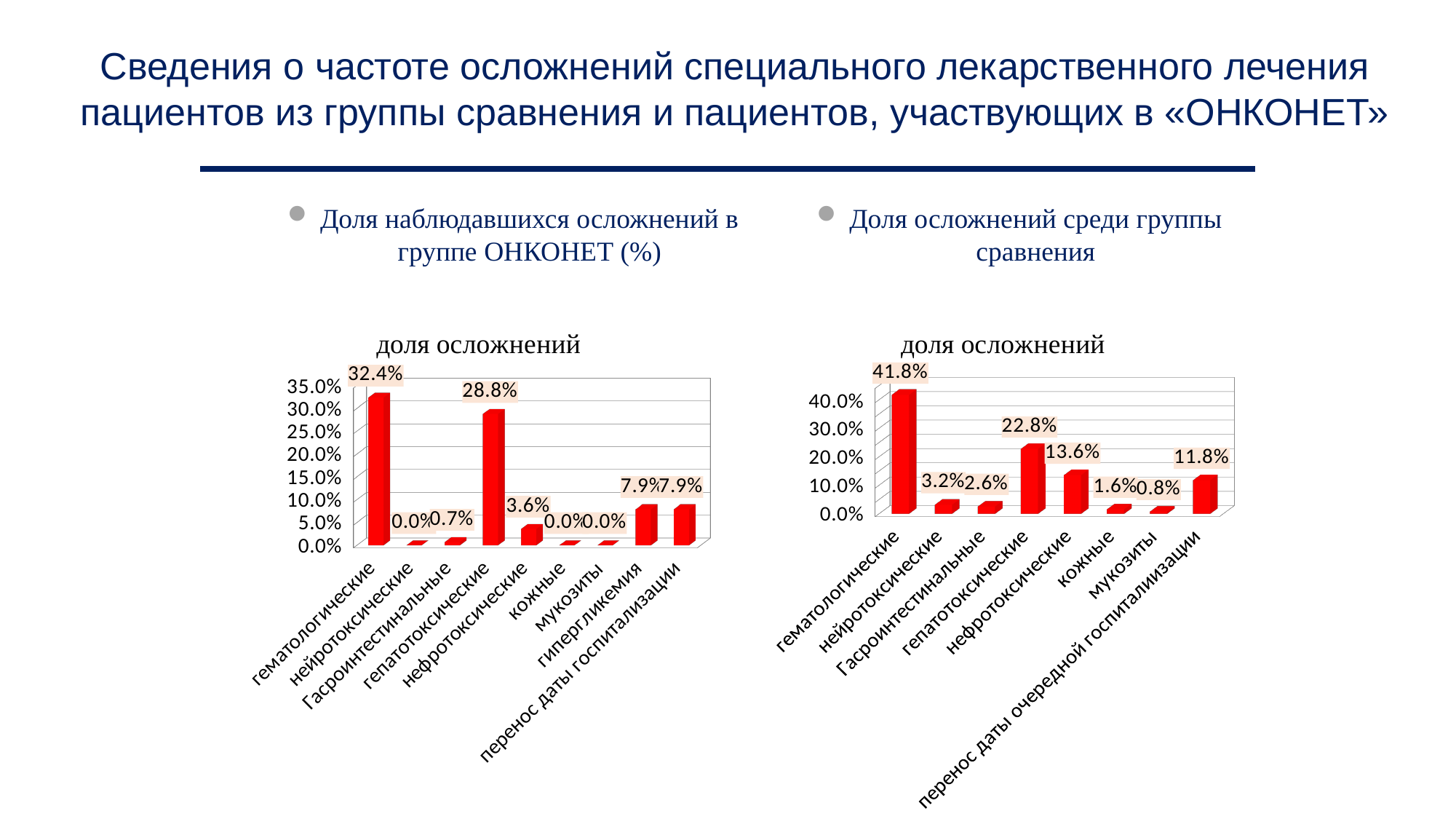
In the left chart (ОНКОНЕТ group), what is the value for гепатотоксические? 28.8% In the right chart (comparison group), which category has the lowest value? мукозиты In the left chart (ОНКОНЕТ group), what is the difference between гематологические and гепатотоксические? 3.6% What type of chart is the left chart (ОНКОНЕТ group)? bar chart How many categories are shown in the right chart (comparison group)? 8 In the right chart (comparison group), what is the difference between гематологические and гепатотоксические? 19.0% In the right chart (comparison group), which is larger: нейротоксические or Гасроинтестинальные? нейротоксические In the left chart (ОНКОНЕТ group), is the value for гепатотоксические greater or less than 25.0%? greater How many categories are shown in the left chart (ОНКОНЕТ group)? 9 In the right chart (comparison group), which category has the highest value? гематологические In the left chart (ОНКОНЕТ group), what is the value for гематологические? 32.4% In the right chart (comparison group), what is the value for нефротоксические? 13.6%